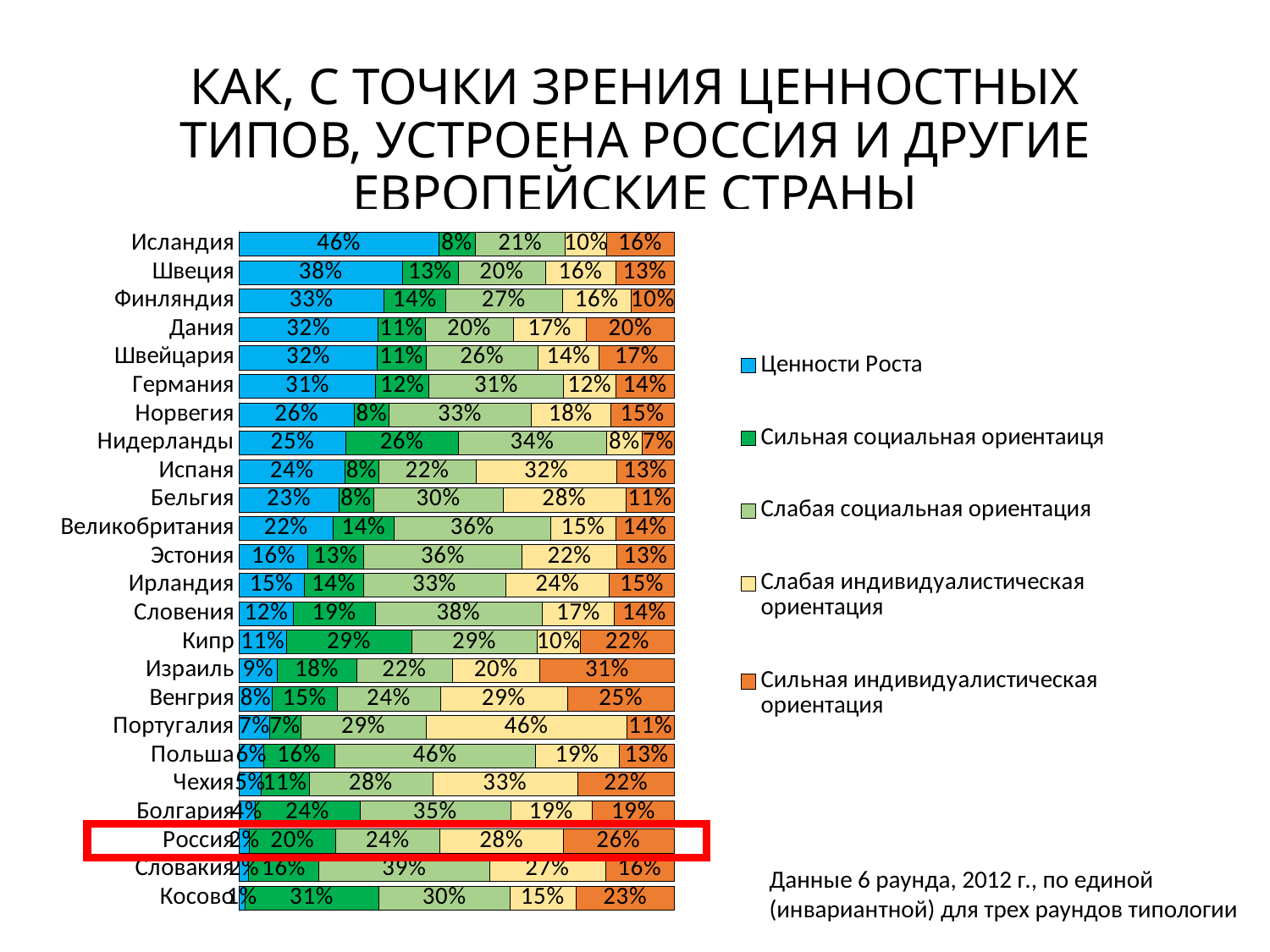
What type of chart is shown on the slide? Stacked bar chart Which is larger: Сильная индивидуалистическая ориентация for Израиль or for Россия? Израиль What is the value of Слабая индивидуалистическая ориентация for Португалия? 46% What is the value of Ценности Роста for Россия? 2% Which country has the highest value of Ценности Роста? Исландия How many countries are listed on the chart? 24 What is the difference in Ценности Роста between Исландия and Швеция? 8 percentage points Which country has the lowest value of Ценности Роста? Косово What is the value of Сильная индивидуалистическая ориентация for Россия? 26% What is the value of Ценности Роста for Исландия? 46% Which country has the highest value of Сильная индивидуалистическая ориентация? Израиль How many series does the legend list? 5